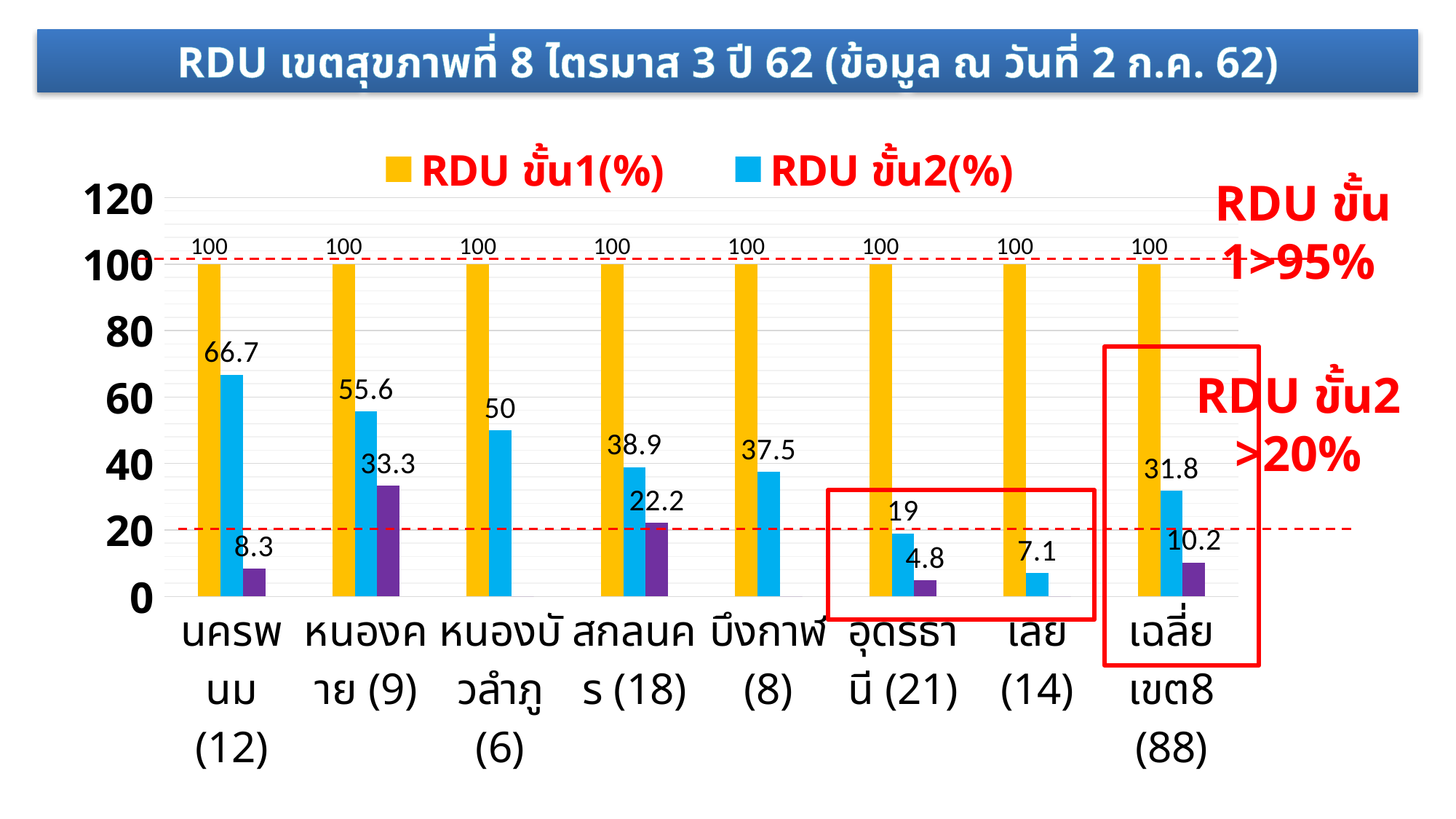
Which category has the highest RDU ขั้น2(%) value? นครพนม (12) What is the difference between the RDU ขั้น2(%) values for หนองคาย (9) and หนองบัวลำภู (6)? 5.6 What is the RDU ขั้น1(%) value for สกลนคร (18)? 100 How many categories are shown on the x axis? 8 What is the RDU ขั้น2(%) value for เฉลี่ยเขต8 (88)? 31.8 Which colour represents RDU ขั้น1(%) in the legend? yellow Which has a larger RDU ขั้น2(%) value, สกลนคร (18) or บึงกาฬ (8)? สกลนคร (18) What is the RDU ขั้น2(%) value for นครพนม (12)? 66.7 What is the RDU ขั้น2(%) value for เลย (14)? 7.1 How many series does the legend list? 2 What kind of chart is shown on the slide? bar chart Which category has the lowest RDU ขั้น2(%) value? เลย (14)